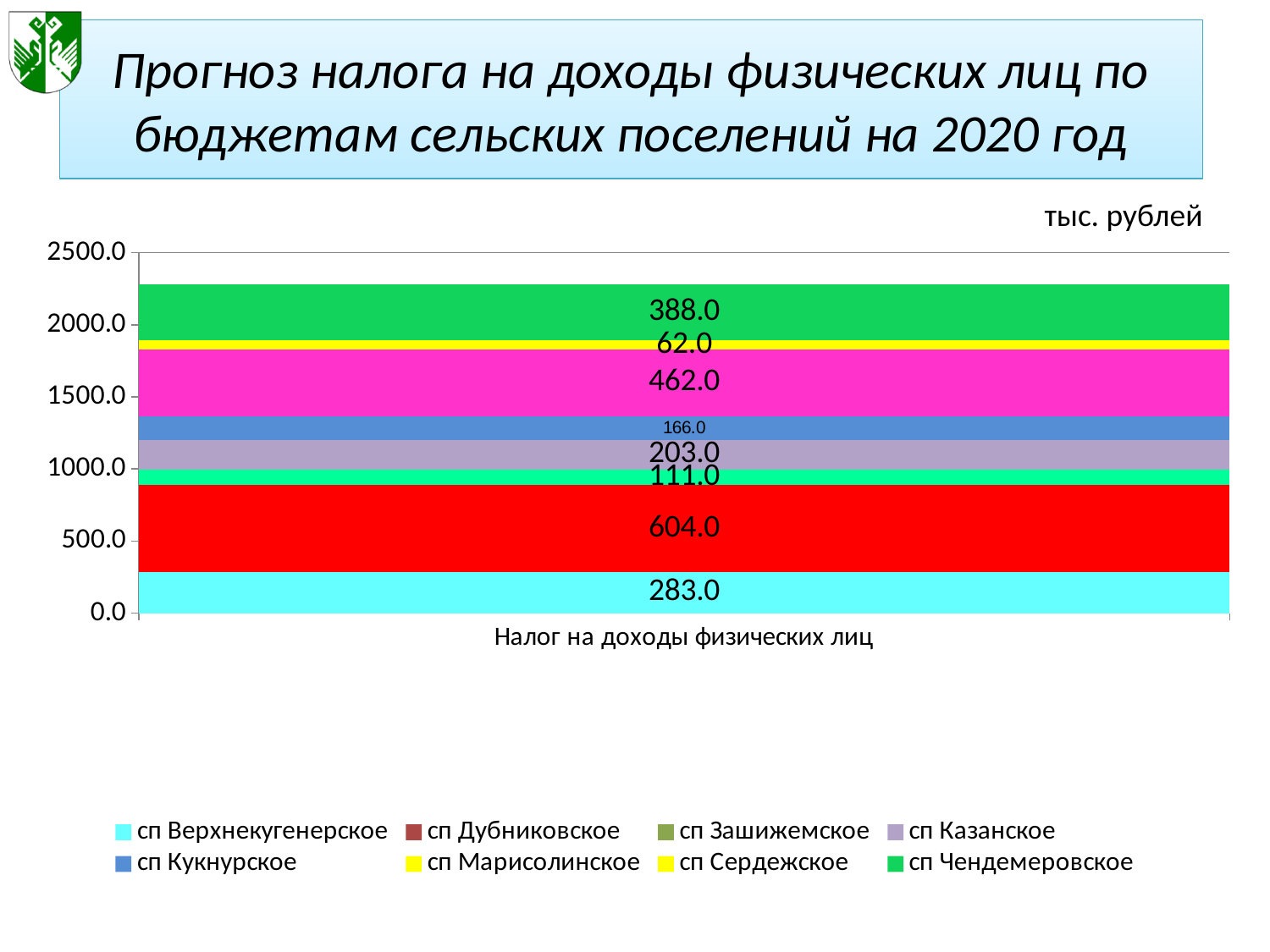
What is the total of the stacked bar? 2279.0 What is the value for сп Чендемеровское? 388.0 What is the smallest value labelled on the stacked bar? 62.0 How many series does the legend list? 8 What is the value for сп Верхнекугенерское? 283.0 What is the largest value labelled on the stacked bar? 604.0 What is the value for сп Казанское? 203.0 Which is larger, the value for сп Верхнекугенерское or the value for сп Кукнурское? сп Верхнекугенерское How many categories are plotted on the x axis? 1 What kind of chart is shown on the slide? stacked bar chart What is the value for сп Кукнурское? 166.0 What is the difference between the values for сп Чендемеровское and сп Казанское? 185.0